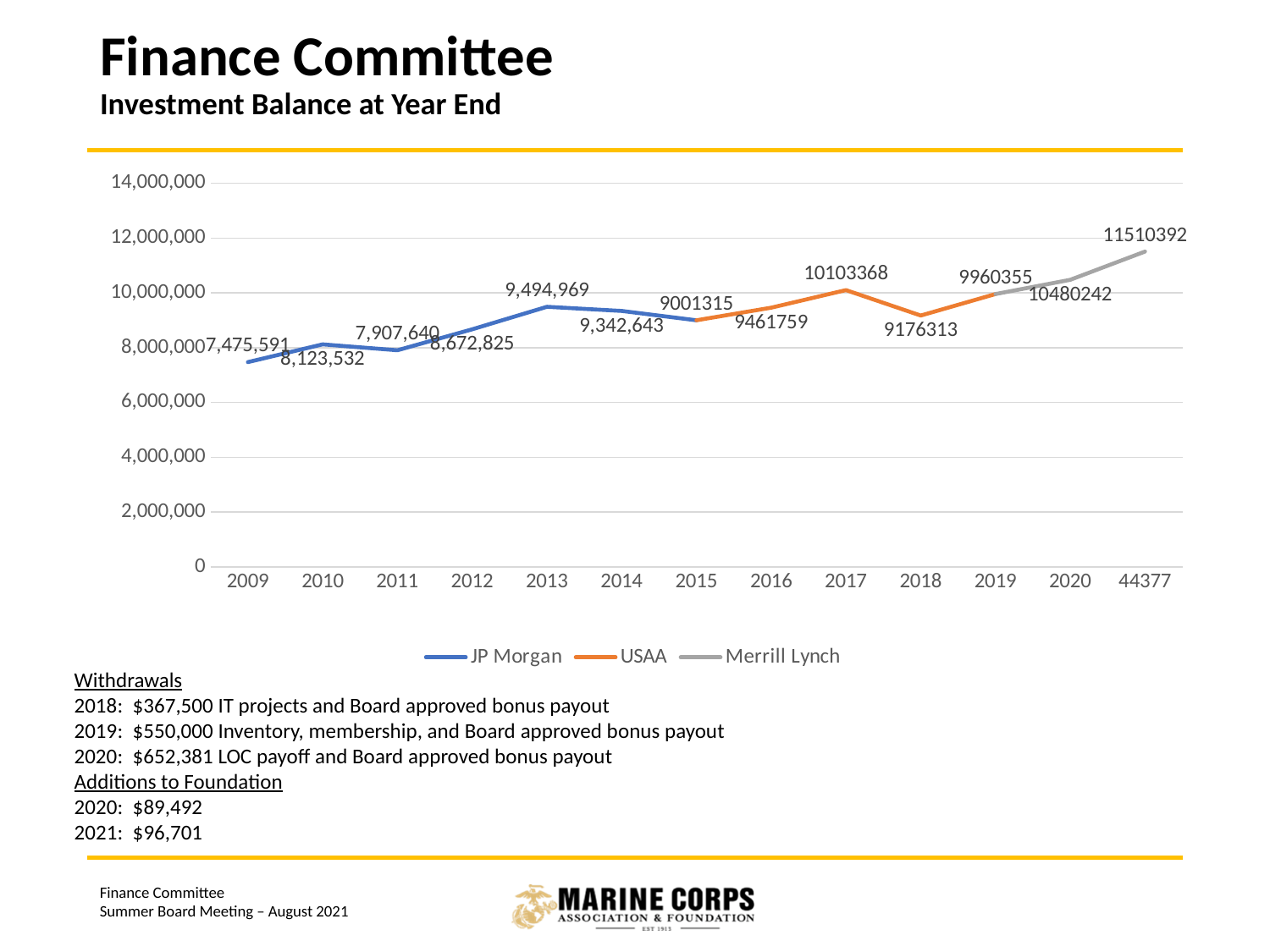
Which year has the lowest investment balance on the chart? 2009 What is the investment balance shown for 2009? 7,475,591 How many series does the chart legend list? 3 Is the investment balance for 2017 greater or less than 10,000,000? greater What type of chart is shown on the slide? line chart What is the investment balance shown for 2017? 10103368 What is the investment balance shown for 2018? 9176313 What is the difference between the investment balance for 2020 and for 2019? 519887 What is the investment balance shown for 2013? 9,494,969 What is the highest investment balance value labeled on the chart? 11510392 Which series in the legend is drawn in orange? USAA Which is larger, the investment balance for 2013 or for 2014? 2013